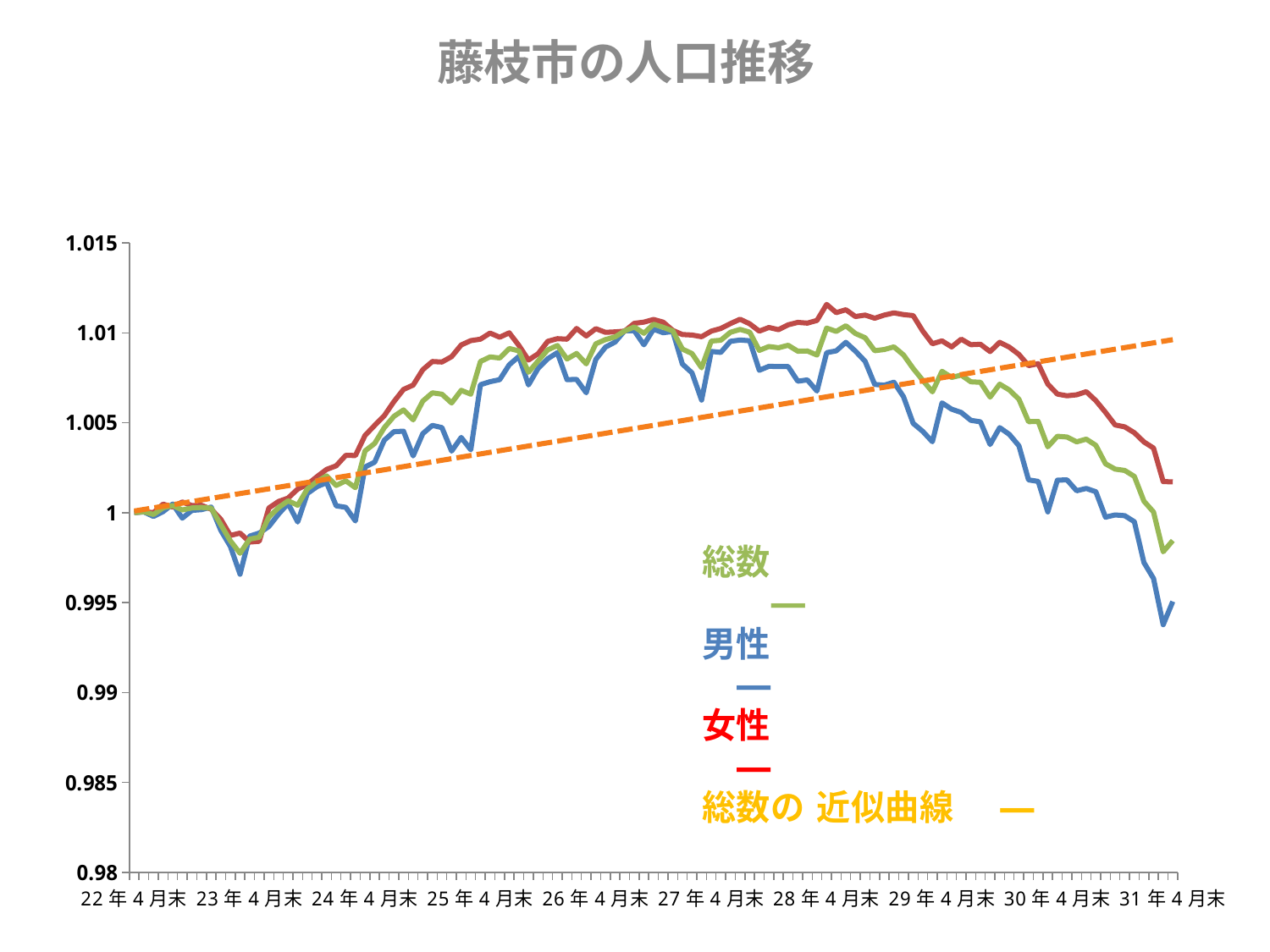
How many entries does the legend list? 4 How many year labels are shown along the x axis? 10 What is the title of the chart? 藤枝市の人口推移 Which series falls to the lowest value on the chart? 男性 Which series reaches the highest value on the chart? 女性 Is the value for 男性 at 31年4月末 greater or less than 1? less Is the value for 女性 at 31年4月末 greater or less than 1? greater What is the value of 総数 at 22年4月末? 1 Which legend entry is drawn as a dashed line? 総数の 近似曲線 At 31年4月末, which series is higher, 女性 or 男性? 女性 What kind of chart is shown on the slide? line chart